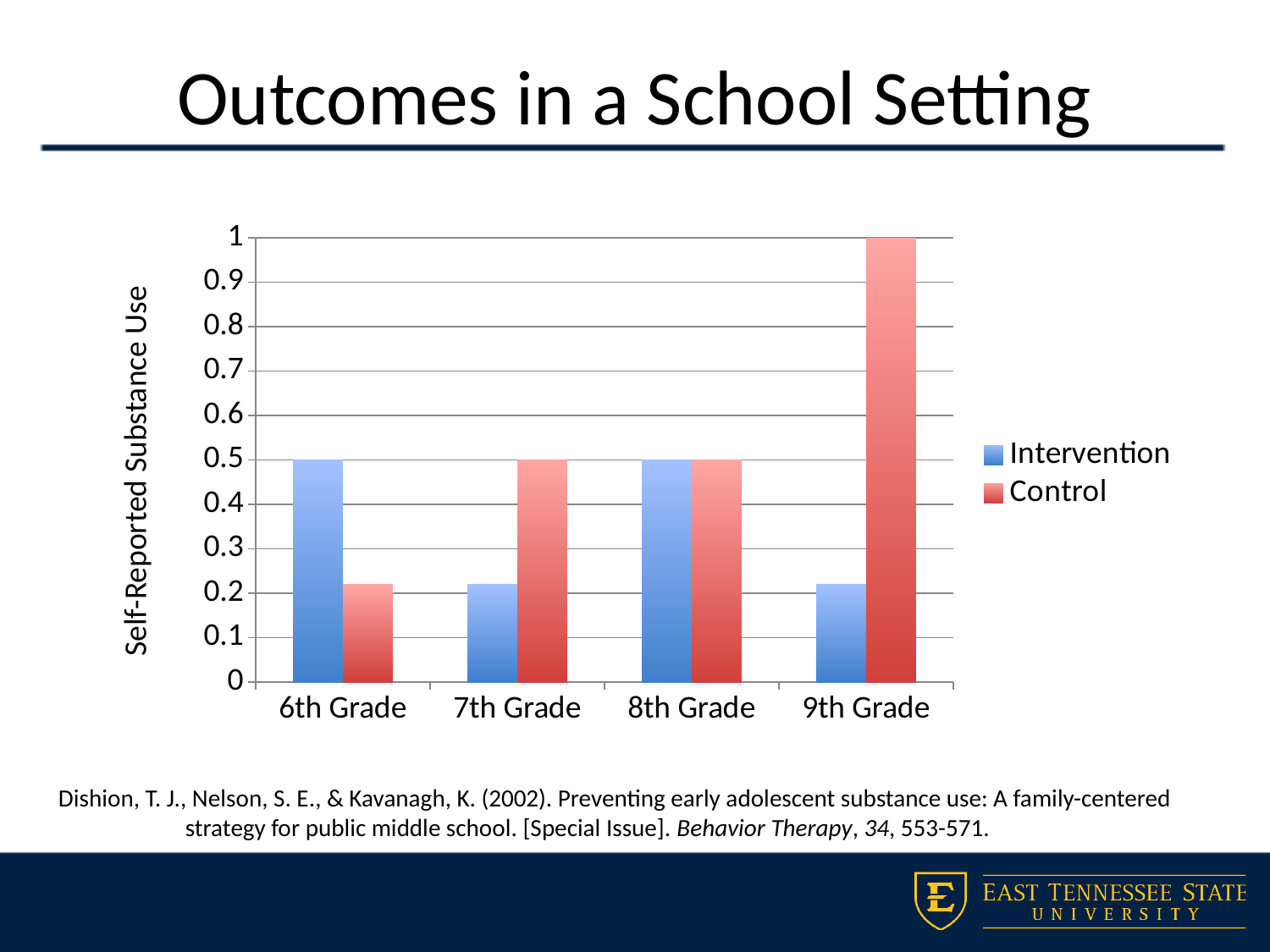
What is the difference between the Control values for 9th Grade and 7th Grade? 0.5 What is the Intervention value for 6th Grade? 0.5 How many grade categories are shown on the x axis? 4 What kind of chart is shown on the slide? bar chart For 6th Grade, which is larger, Intervention or Control? Intervention What is the Control value for 7th Grade? 0.5 Which grade has the highest Control value? 9th Grade What is the label on the vertical axis? Self-Reported Substance Use Which grade has the lowest Control value? 6th Grade What is the Control value for 9th Grade? 1 How many series does the legend list? 2 Is the Intervention value for 9th Grade greater or less than 0.3? less